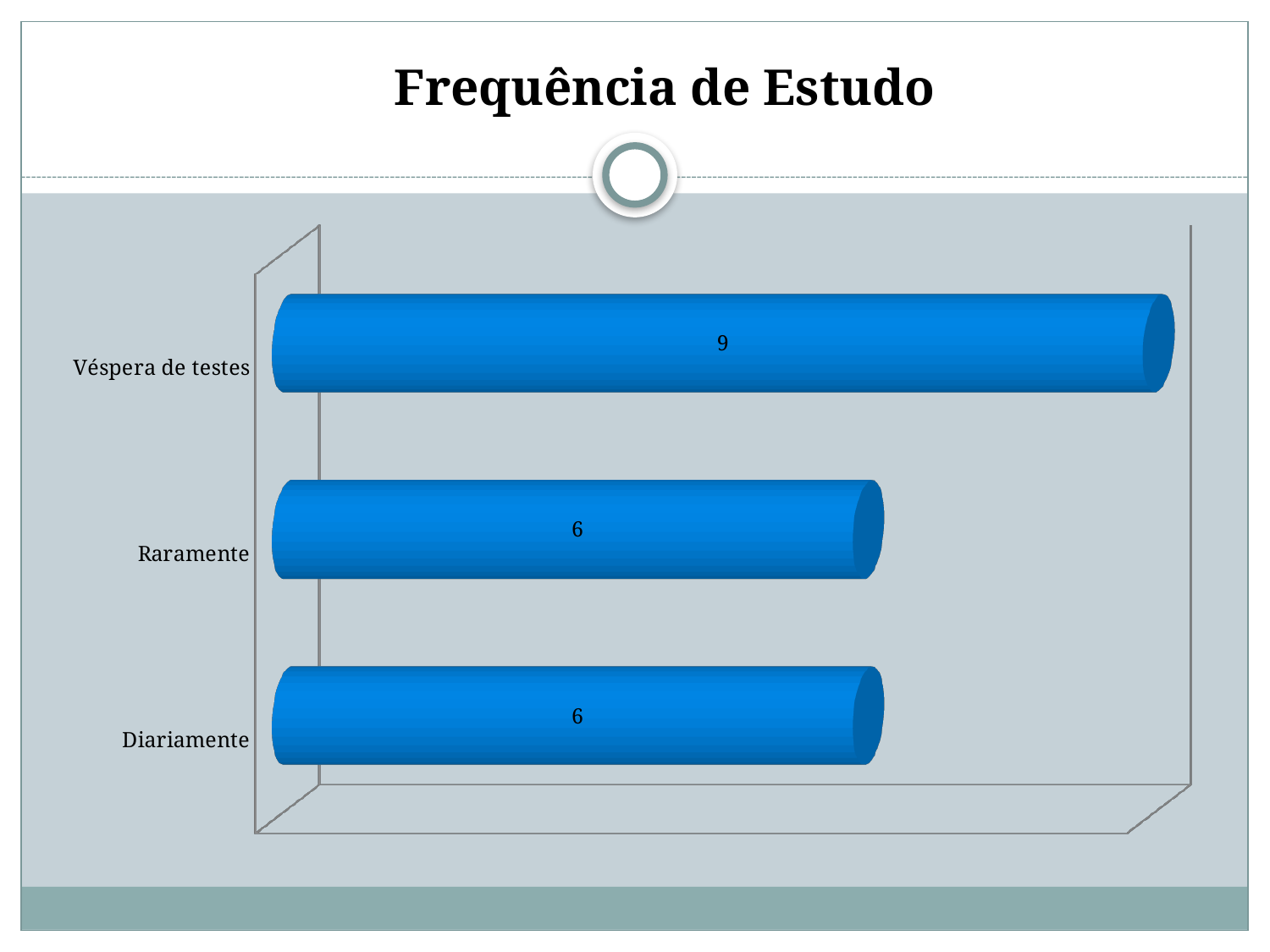
What is the value for Véspera de testes? 9 What is the total of all the values shown in the chart? 21 Which category has the highest value? Véspera de testes What is the difference between the values for Véspera de testes and Raramente? 3 What is the title of the slide? Frequência de Estudo What colour are the bars in the chart? Blue Do Raramente and Diariamente have the same value? Yes Which is larger, the value for Véspera de testes or the value for Diariamente? Véspera de testes What is the value for Diariamente? 6 How many categories are shown in the chart? 3 What kind of chart is shown on the slide? Bar chart What is the value for Raramente? 6